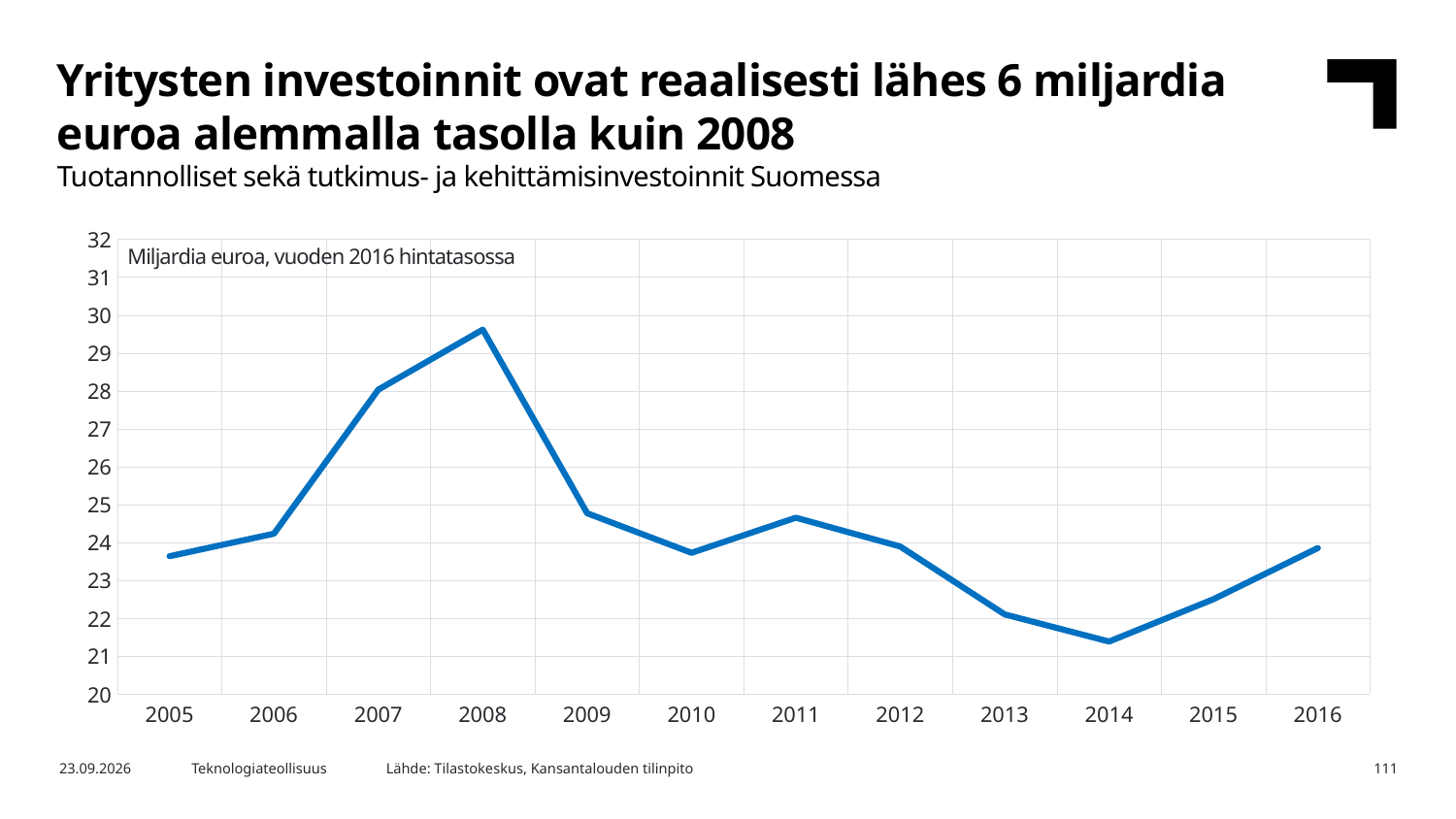
What kind of chart is shown on the slide? line chart Which year has a larger value, 2011 or 2013? 2011 In which year is the value of investments highest? 2008 Do the values rise or fall between 2008 and 2010? fall Which year has a larger value, 2007 or 2009? 2007 Is the value for 2014 greater or less than 22? less What unit is stated in the label inside the chart area? Miljardia euroa, vuoden 2016 hintatasossa Is the value for 2007 greater or less than 27? greater Is the value for 2013 greater or less than 23? less In which year is the value of investments lowest? 2014 How many years are plotted on the x axis of the chart? 12